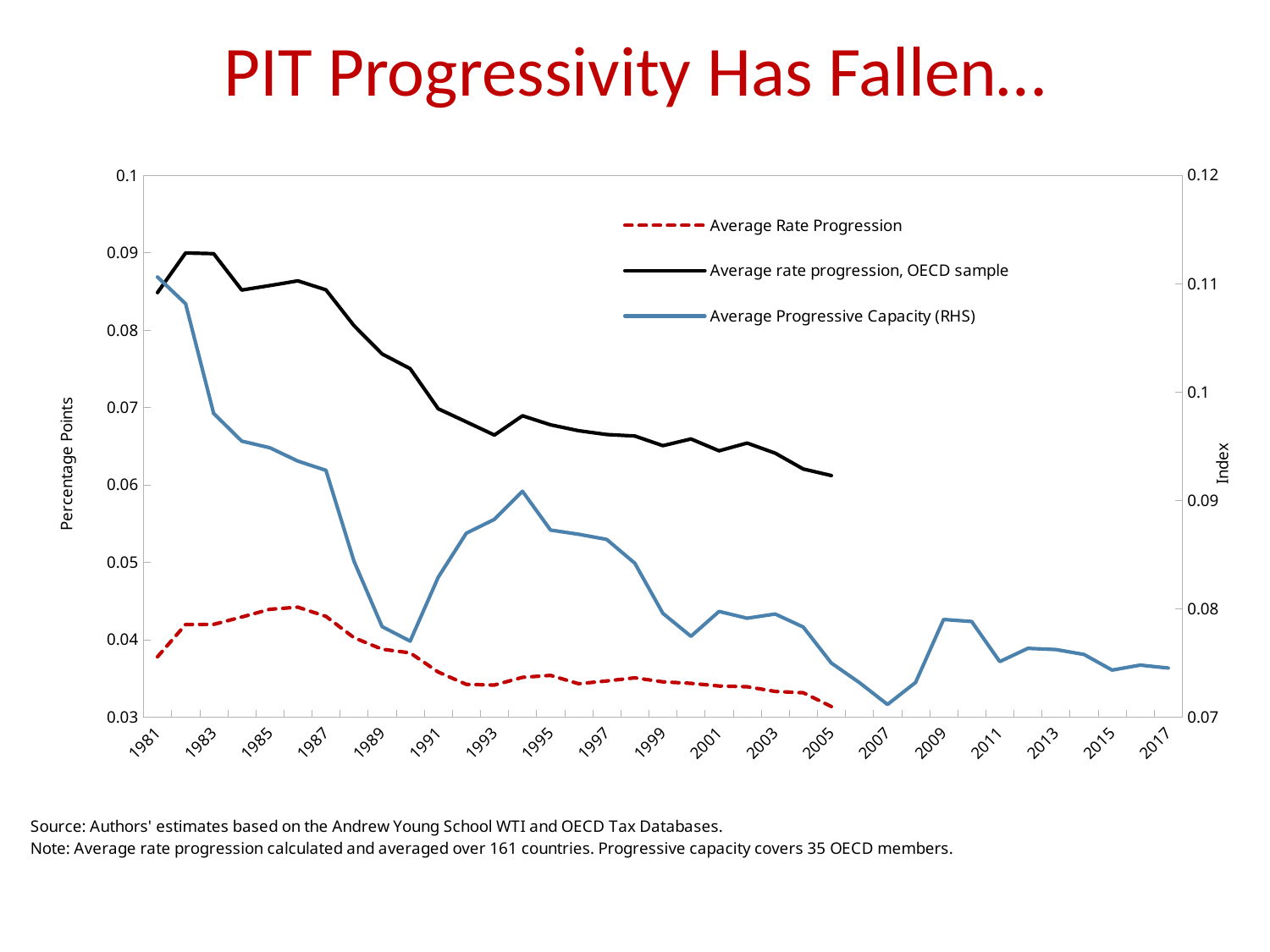
Is the value for Average rate progression, OECD sample in 1981 greater or less than 0.08? greater How many series does the legend list? 3 Is the value for Average Rate Progression in 1981 greater or less than 0.04? less Which series is drawn as a red dashed line? Average Rate Progression Does the Average rate progression, OECD sample series rise or fall overall from 1981 to 2005? fall In 1981, which is larger: Average rate progression, OECD sample or Average Rate Progression? Average rate progression, OECD sample What is the last year labelled on the x axis? 2017 What is the title of the slide's chart? PIT Progressivity Has Fallen… What kind of chart is shown on the slide? line chart Is the value for Average Progressive Capacity (RHS) in 1981 greater or less than 0.1 on the right-hand axis? greater Does the Average Progressive Capacity (RHS) series rise or fall overall from 1981 to 2017? fall